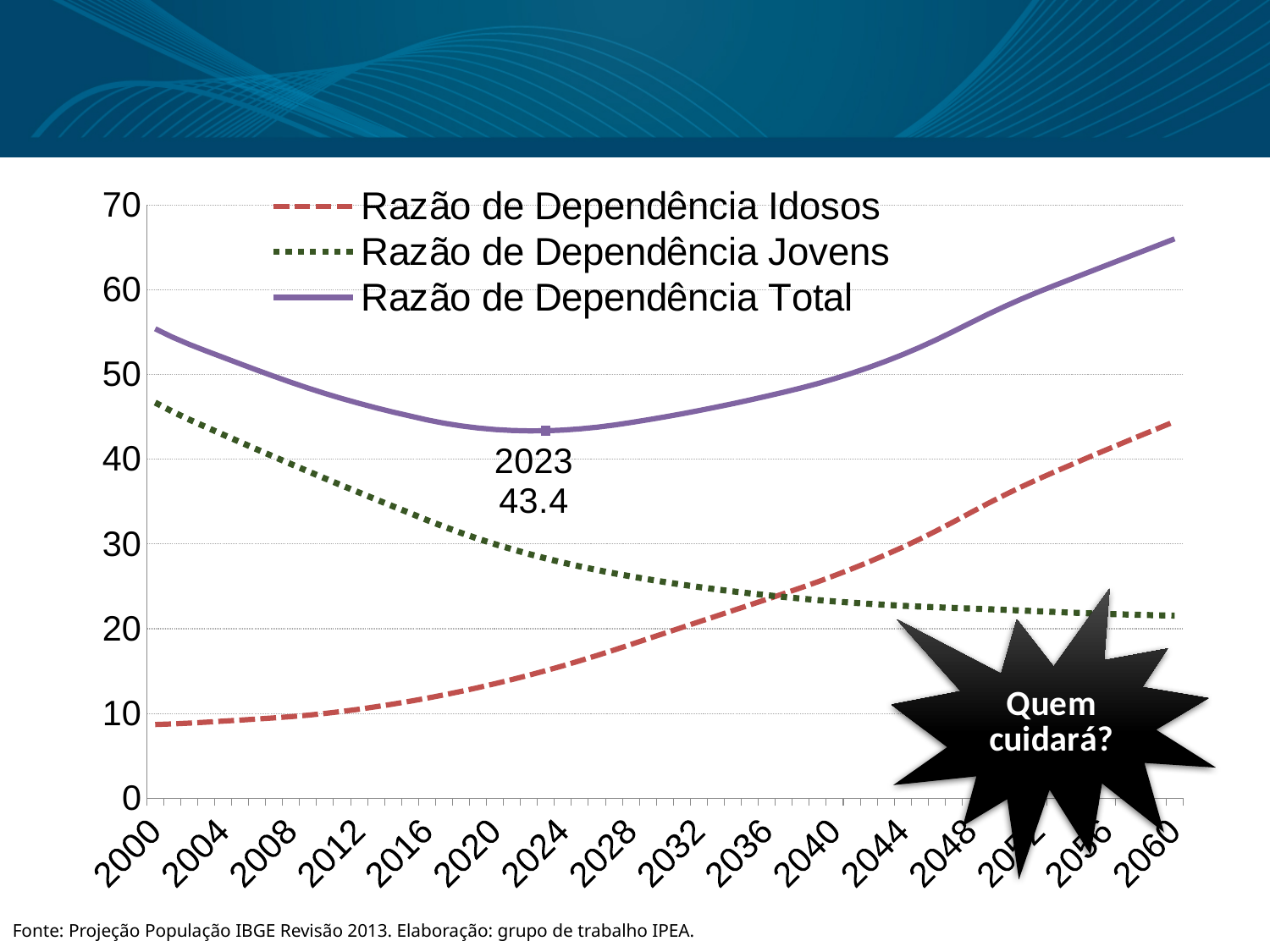
In 2000, which is higher: Razão de Dependência Idosos or Razão de Dependência Jovens? Razão de Dependência Jovens What kind of chart is shown on the slide? line chart Is the value for Razão de Dependência Total in 2060 greater or less than 60? greater How many series does the legend list? 3 Does the Razão de Dependência Idosos line rise or fall from 2000 to 2060? rise Does the Razão de Dependência Jovens line rise or fall from 2000 to 2060? fall In which year does the Razão de Dependência Total line reach its lowest point? 2023 What is the value of Razão de Dependência Total in 2023? 43.4 In 2060, which is higher: Razão de Dependência Idosos or Razão de Dependência Jovens? Razão de Dependência Idosos Which series is drawn as the solid purple line? Razão de Dependência Total Is the value for Razão de Dependência Idosos in 2000 greater or less than 10? less Is the value for Razão de Dependência Jovens in 2000 greater or less than 40? greater